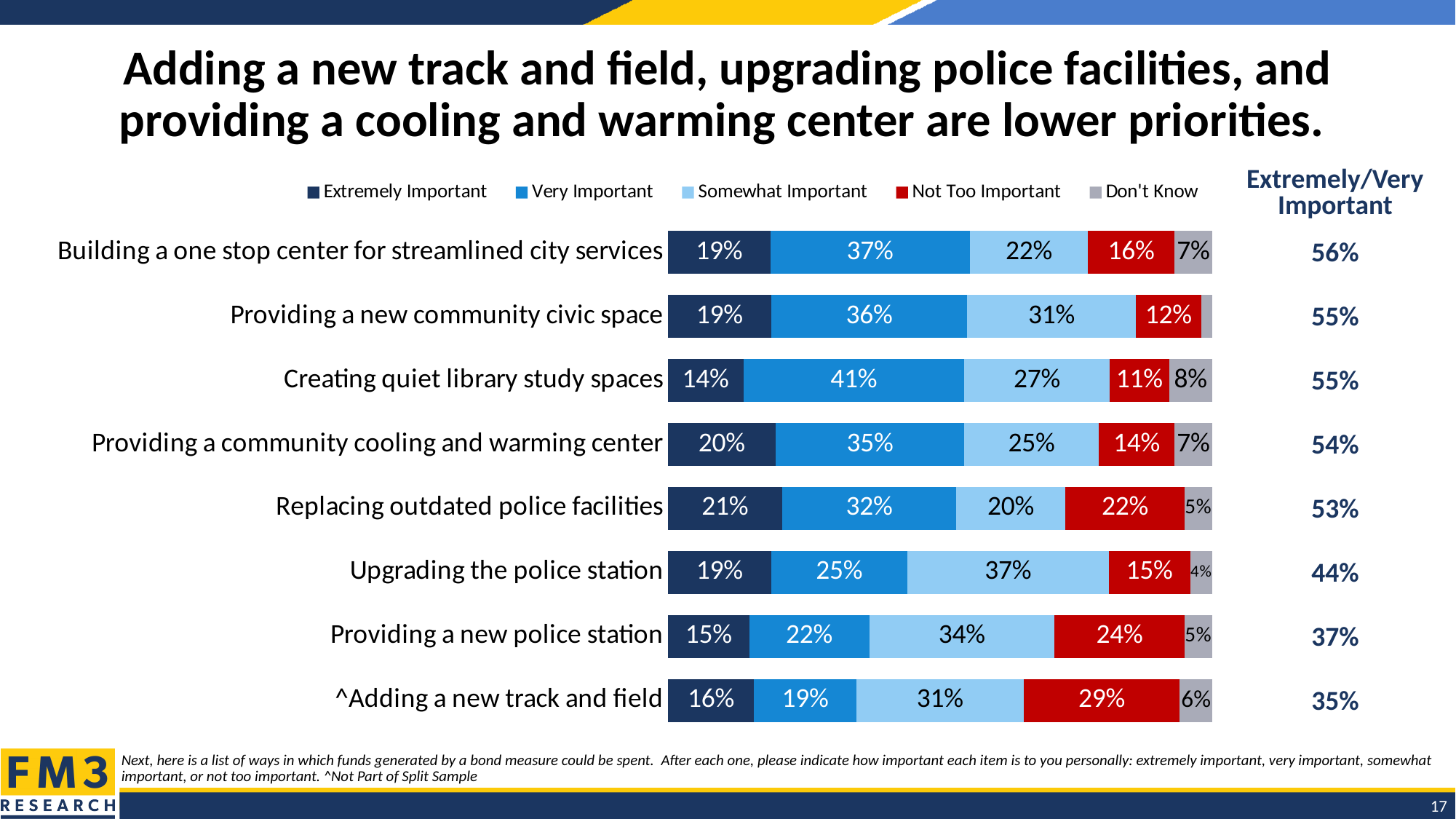
What is the Extremely Important percentage for 'Replacing outdated police facilities'? 21% How many series does the legend list? 5 What percentage rated 'Creating quiet library study spaces' as Very Important? 41% How many items (bars) are shown in the chart? 8 What percentage rated '^Adding a new track and field' as Not Too Important? 29% Which item has the highest Very Important percentage? Creating quiet library study spaces How many percentage points higher is the Somewhat Important share for 'Upgrading the police station' than for 'Replacing outdated police facilities'? 17 percentage points What colour represents 'Not Too Important' in the legend? Red What kind of chart is shown on the slide? Stacked bar chart Which item has the lowest combined Extremely/Very Important percentage? ^Adding a new track and field Which has a larger Not Too Important share: 'Providing a new police station' or 'Replacing outdated police facilities'? Providing a new police station Which item has the highest combined Extremely/Very Important percentage? Building a one stop center for streamlined city services